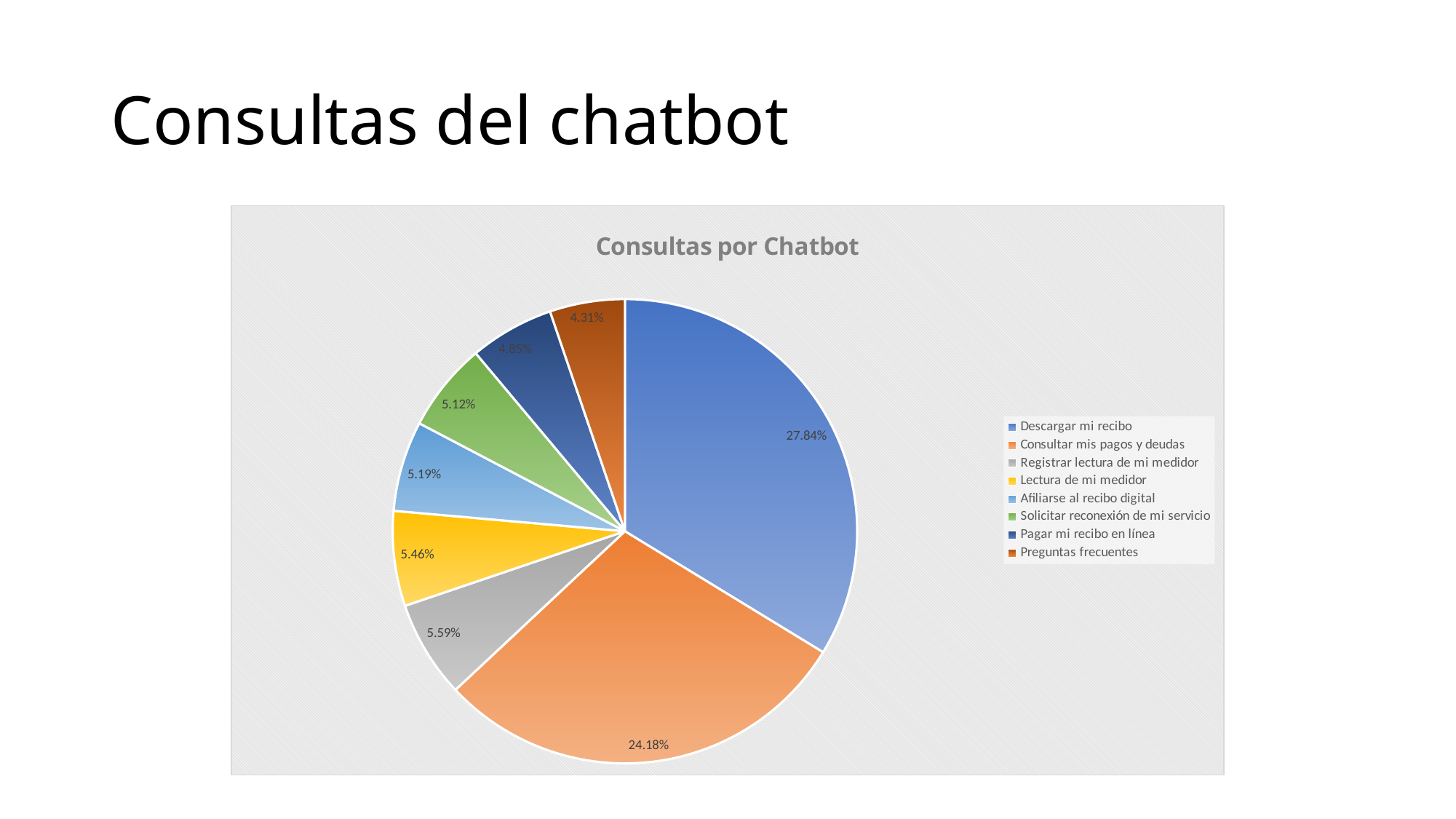
Which category has the largest slice of the pie? Descargar mi recibo What share of the pie does 'Descargar mi recibo' represent? 27.84% What is the difference between the shares of 'Descargar mi recibo' and 'Consultar mis pagos y deudas'? 3.66% What is the value shown for 'Preguntas frecuentes'? 4.31% What kind of chart is shown on the slide? Pie chart How many categories does the legend list? 8 Which category has the smallest slice of the pie? Preguntas frecuentes Which is larger: the share for 'Afiliarse al recibo digital' or the share for 'Pagar mi recibo en línea'? Afiliarse al recibo digital What is the value shown for 'Registrar lectura de mi medidor'? 5.59% What is the title of the chart? Consultas por Chatbot What share of the pie does 'Consultar mis pagos y deudas' represent? 24.18% What is the value shown for 'Lectura de mi medidor'? 5.46%